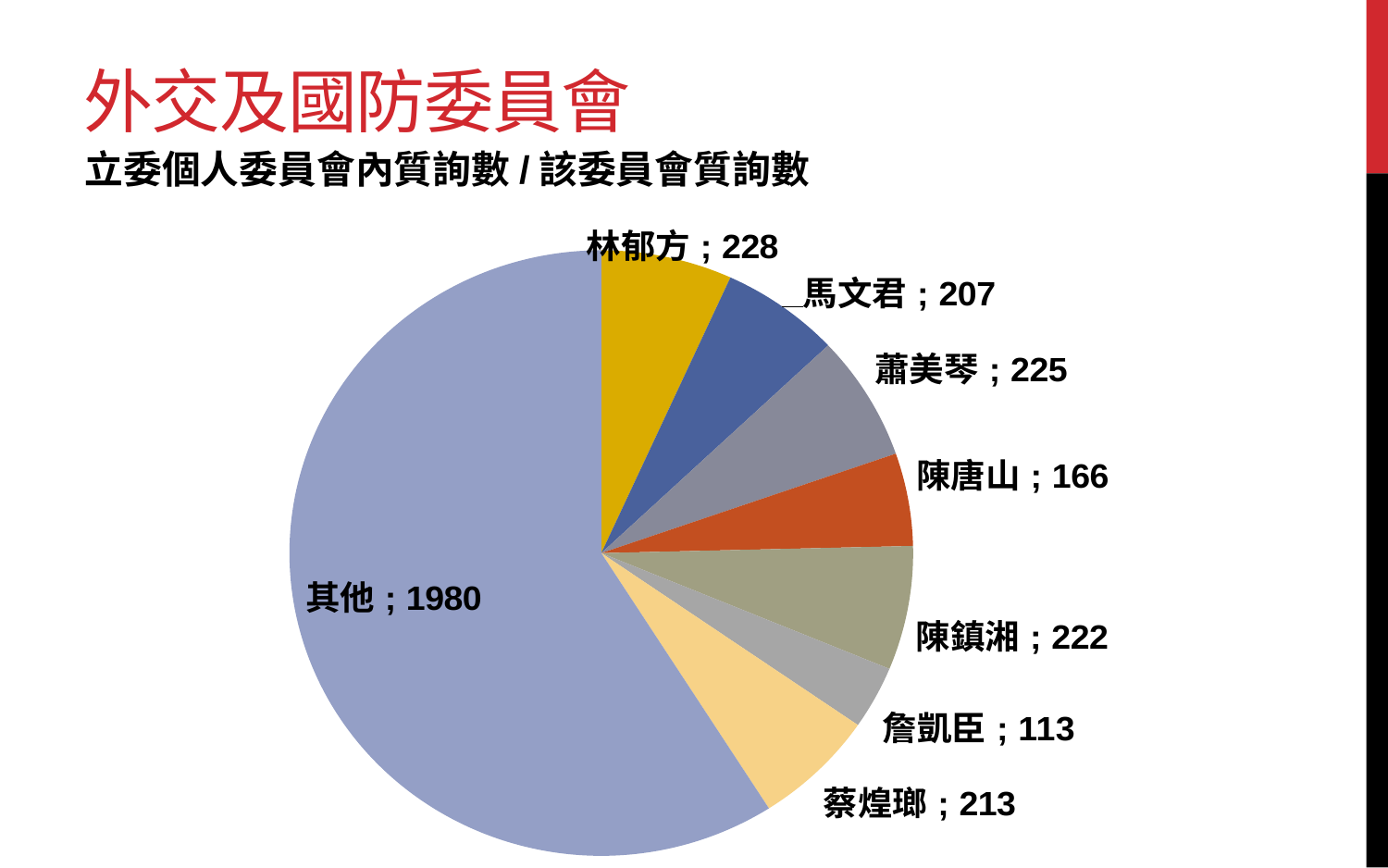
What is the value for 蔡煌瑯? 213 What is the title of the slide containing the chart? 外交及國防委員會 What kind of chart is shown on the slide? pie chart What is the value for 其他? 1980 What is the difference between the values for 林郁方 and 馬文君? 21 What is the difference between the values for 陳鎮湘 and 詹凱臣? 109 Which is larger, the value for 陳唐山 or the value for 詹凱臣? 陳唐山 Which slice has the smallest value? 詹凱臣 Which slice has the largest value? 其他 What is the value for 陳唐山? 166 How many slices does the pie chart have? 8 What is the value for 林郁方? 228